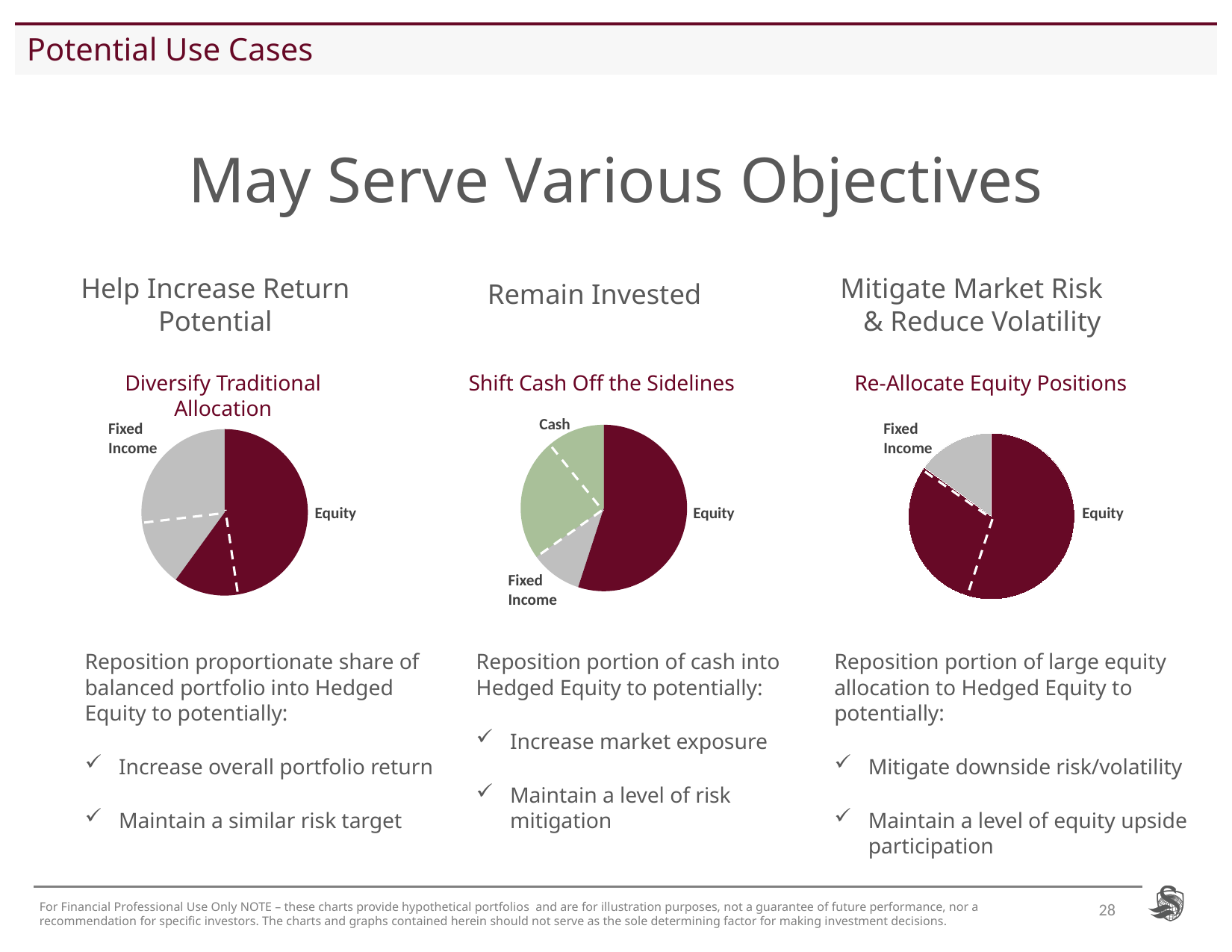
In the "Shift Cash Off the Sidelines" chart, how many labeled slices are there? 3 In the "Diversify Traditional Allocation" chart, how many labeled slices are there? 2 In the "Diversify Traditional Allocation" chart, which slice is larger, Equity or Fixed Income? Equity How many pie charts are shown on the slide? 3 In the "Re-Allocate Equity Positions" chart, which slice is larger, Equity or Fixed Income? Equity What is the title of the pie chart under "Mitigate Market Risk & Reduce Volatility"? Re-Allocate Equity Positions In the "Shift Cash Off the Sidelines" chart, which slice is the largest? Equity In the "Shift Cash Off the Sidelines" chart, what colour is the Cash slice? Green In the "Shift Cash Off the Sidelines" chart, which slice is the smallest? Fixed Income In the "Re-Allocate Equity Positions" chart, which slice is the smallest? Fixed Income In the "Shift Cash Off the Sidelines" chart, which slice is larger, Cash or Fixed Income? Cash What kind of chart is used under "Diversify Traditional Allocation"? Pie chart